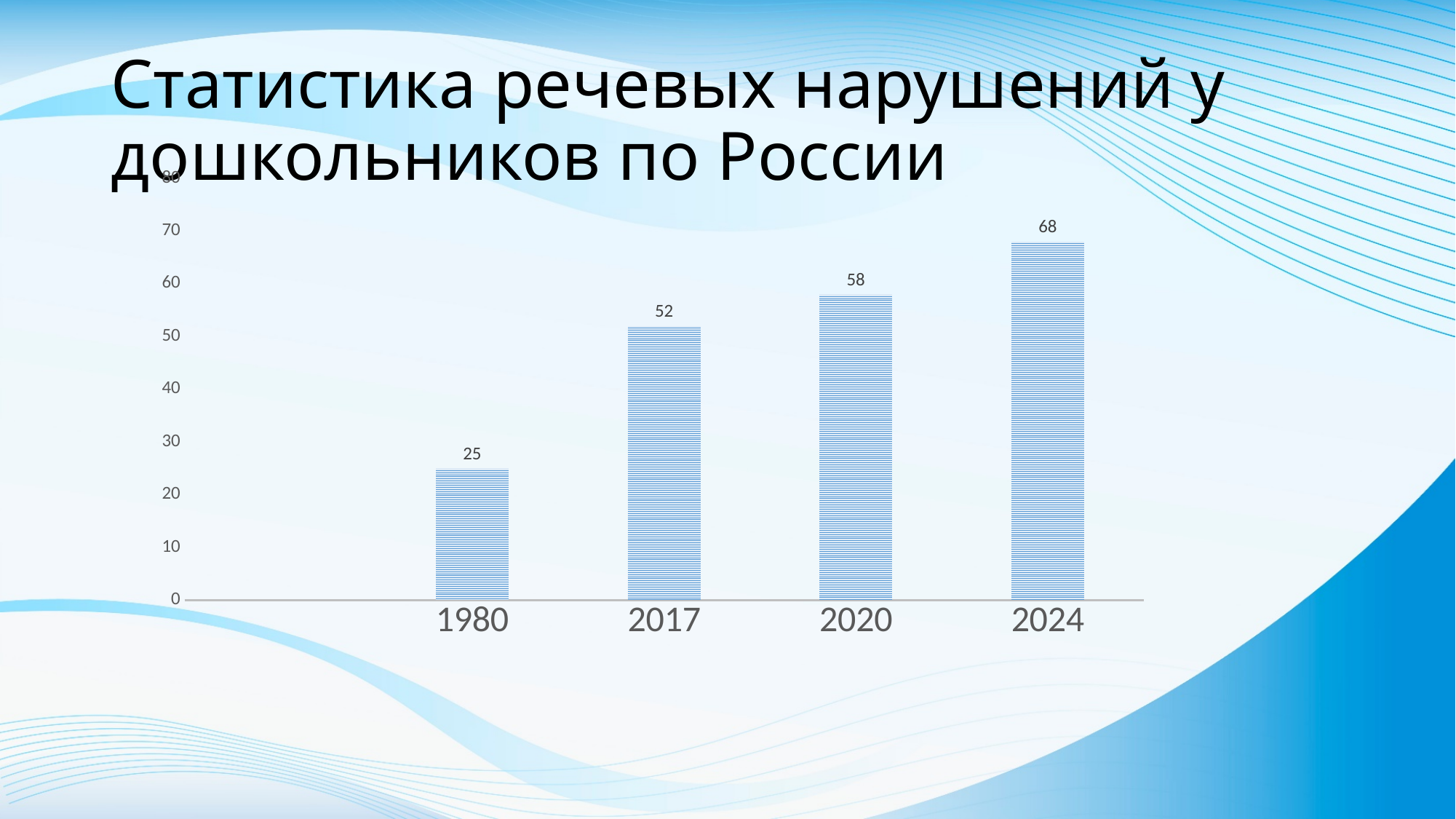
What is the difference between the values for 2020 and 2017? 6 Which year has the lowest value? 1980 Do the values rise or fall from 1980 to 2024? Rise Which year has the highest value? 2024 What is the value for 1980? 25 What kind of chart is shown on the slide? Bar chart What is the value for 2020? 58 What is the value for 2017? 52 Which is larger, the value for 2017 or the value for 2020? 2020 What is the difference between the values for 2024 and 1980? 43 What is the value for 2024? 68 How many years are shown on the x axis? 4